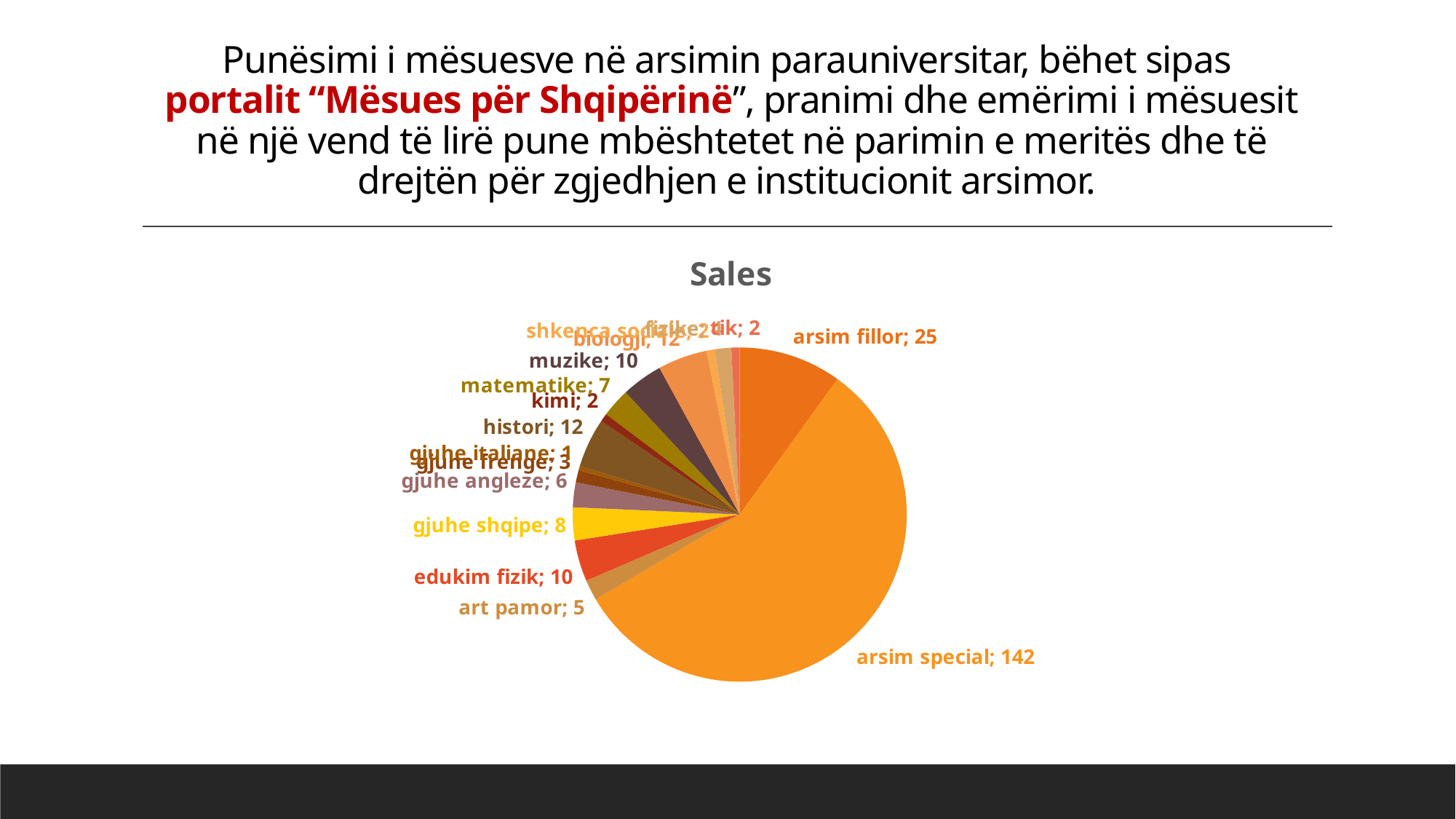
What is the value for edukim fizik? 10 Which category has the smallest value shown? gjuhe italiane What is the value for arsim special? 142 What is the value for gjuhe shqipe? 8 What is the value for arsim fillor? 25 What is the title of the chart? Sales Which category has the largest slice of the pie? arsim special What is the difference between the values for histori and matematike? 5 What is the value for histori? 12 What is the difference between the values for arsim special and arsim fillor? 117 Which is larger, the value for arsim fillor or the value for histori? arsim fillor What type of chart is shown on the slide? pie chart